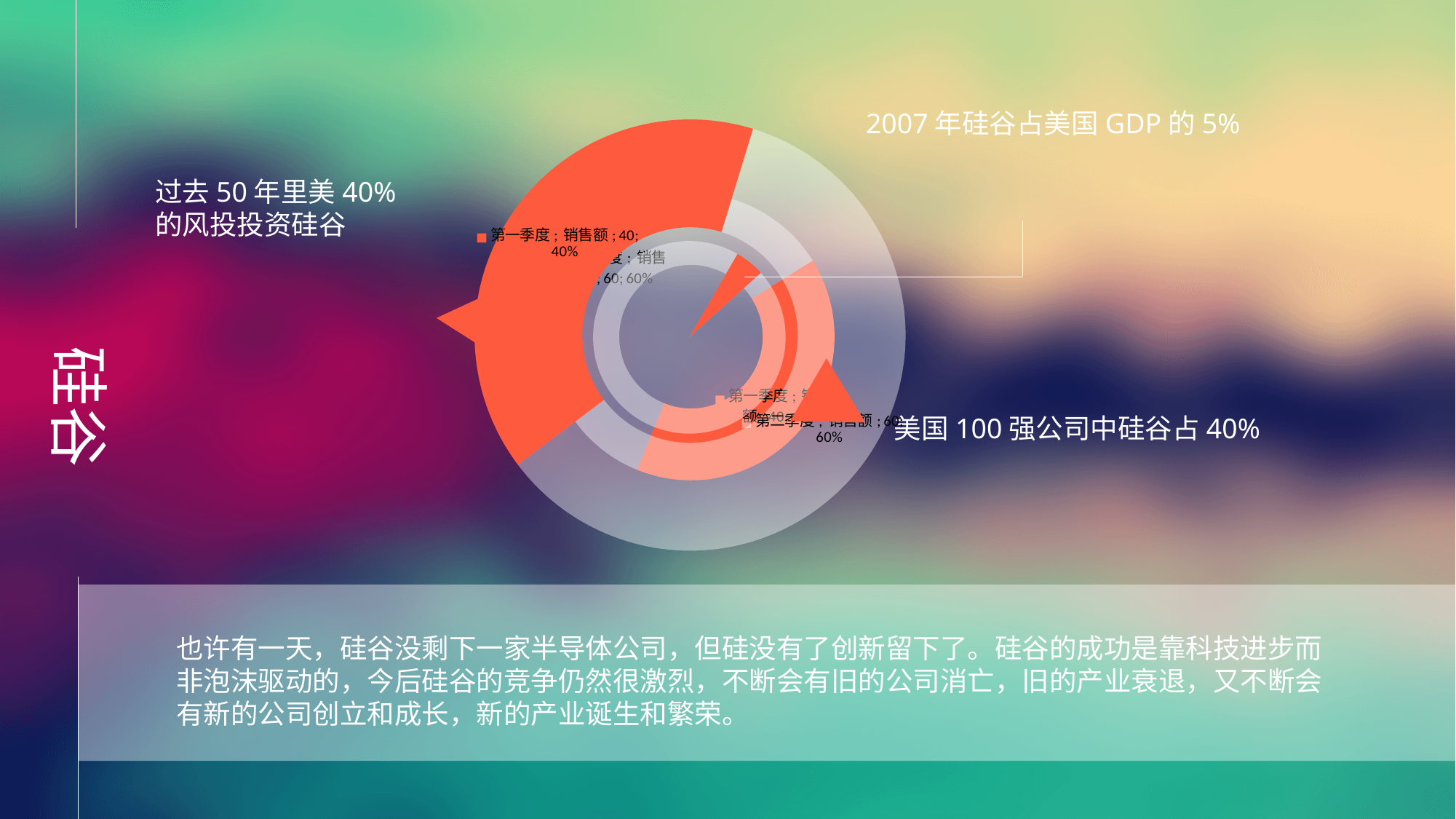
In the front orange pie chart, what is the difference between the values for 第二季度 and 第一季度? 20 In the front orange pie chart, what share of the pie does 第二季度 take? 60% In the front orange pie chart, what value is shown for 第一季度? 40 In the front orange pie chart, what value is shown for 第二季度? 60 How many categories are labelled in the front orange pie chart? 2 In the front orange pie chart, which slice is larger, 第一季度 or 第二季度? 第二季度 In the front orange pie chart, which category has the largest slice? 第二季度 What kind of chart is shown in the centre of the slide? pie chart What series name appears in the data labels of the pie chart? 销售额 In the front orange pie chart, what share of the pie does 第一季度 take? 40% In the front orange pie chart, which category has the smallest slice? 第一季度